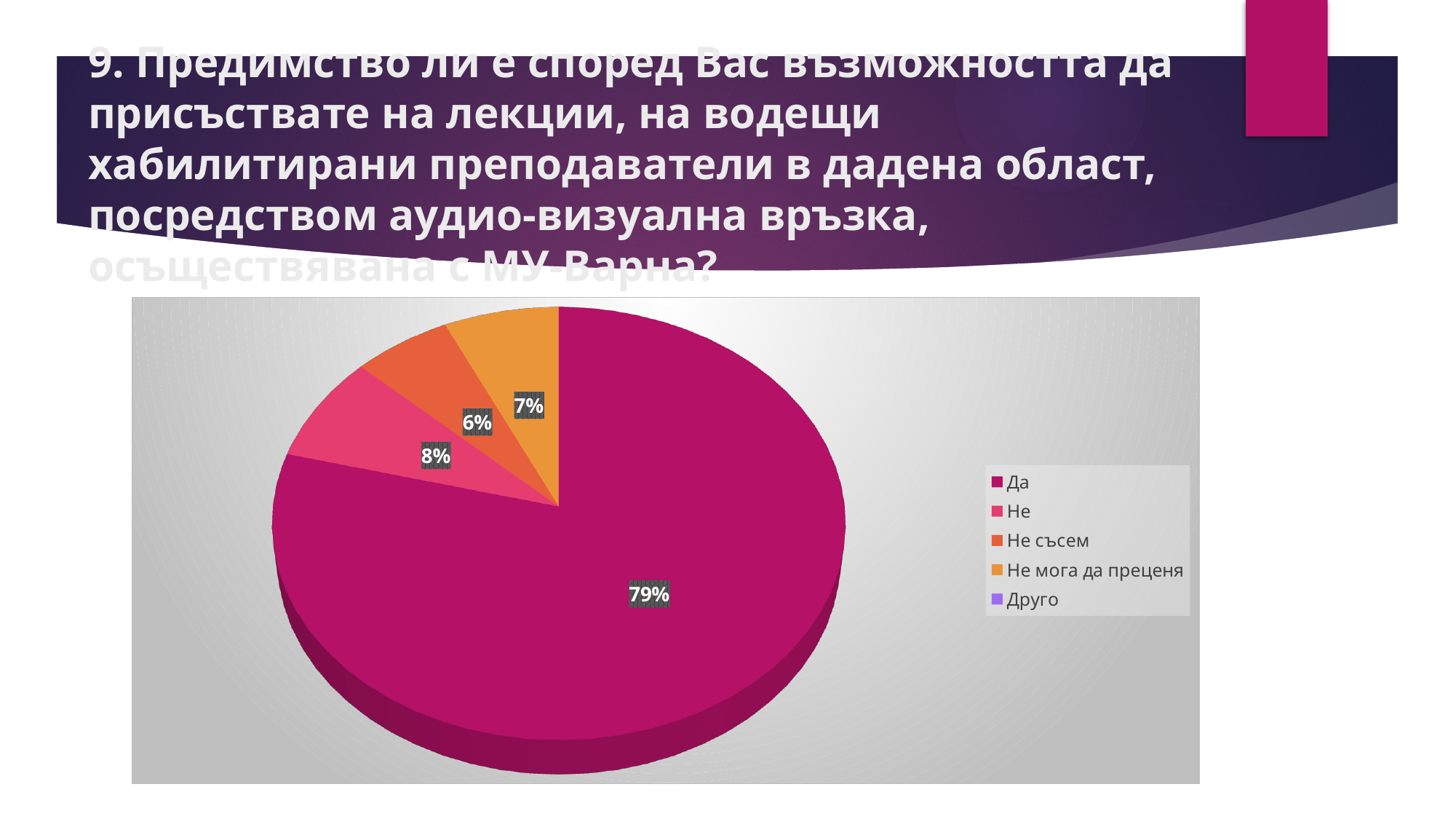
What share of the pie does "Да" have? 79% Which category has the largest slice of the pie? Да Which of the labelled slices is the smallest? Не съсем What kind of chart is shown on the slide? pie chart What share of the pie does "Не съсем" have? 6% What share of the pie does "Не" have? 8% What colour is the slice for "Не мога да преценя"? orange How many entries does the legend list? 5 What is the difference between the shares for "Да" and "Не"? 71% Which legend entry has no visible slice in the pie? Друго What share of the pie does "Не мога да преценя" have? 7% Which is larger, the share for "Не" or the share for "Не мога да преценя"? Не